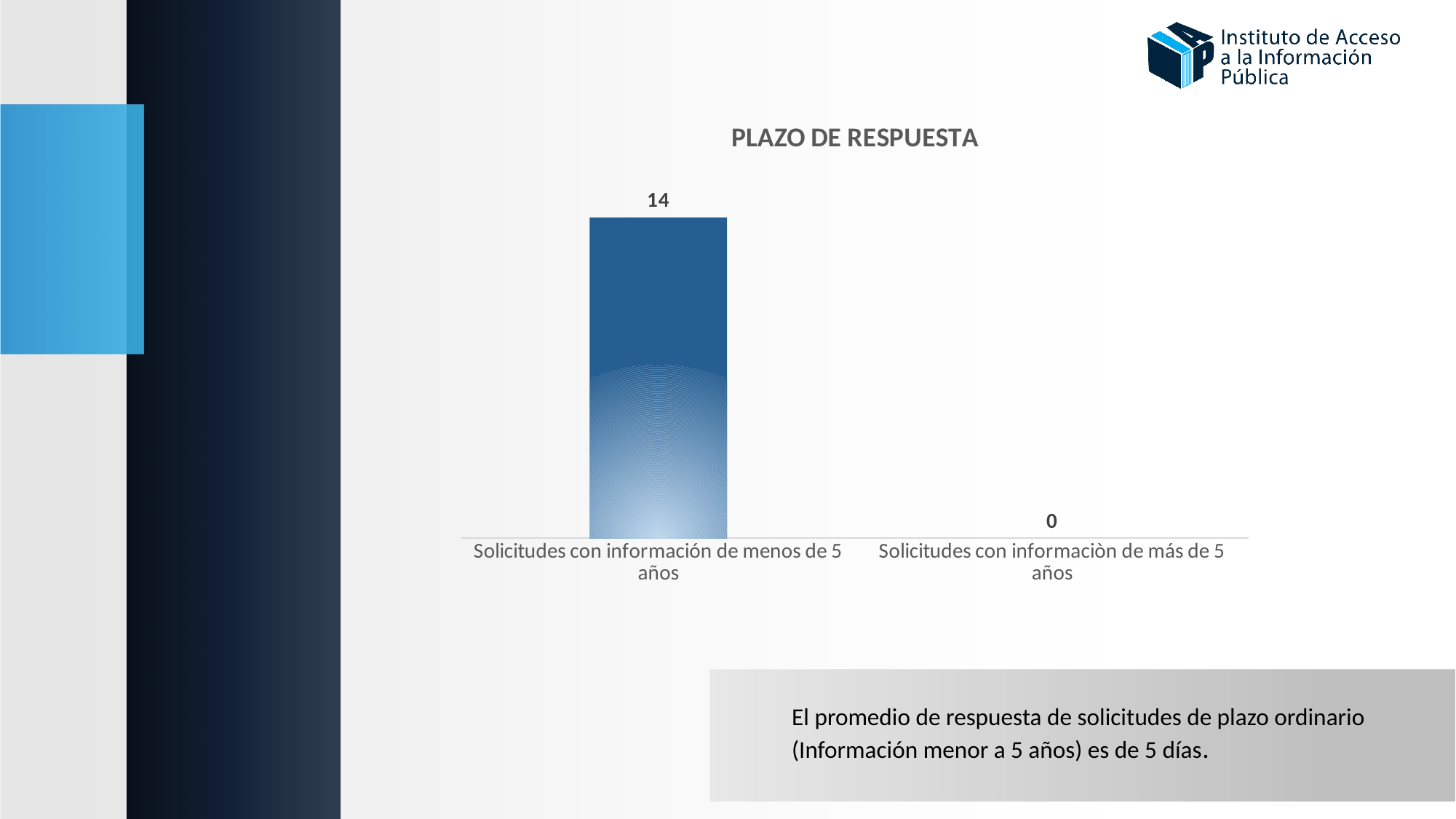
What kind of chart is shown on the slide? Bar chart What is the value for 'Solicitudes con informaciòn de más de 5 años'? 0 Which category has the lowest value? Solicitudes con informaciòn de más de 5 años What is the title of the chart? PLAZO DE RESPUESTA How many categories are shown in the chart? 2 Which is larger: the value for 'Solicitudes con información de menos de 5 años' or 'Solicitudes con informaciòn de más de 5 años'? Solicitudes con información de menos de 5 años What is the total of the two values shown in the chart? 14 What is the difference between the value for 'Solicitudes con información de menos de 5 años' and 'Solicitudes con informaciòn de más de 5 años'? 14 What is the value for 'Solicitudes con información de menos de 5 años'? 14 Which category has the highest value? Solicitudes con información de menos de 5 años